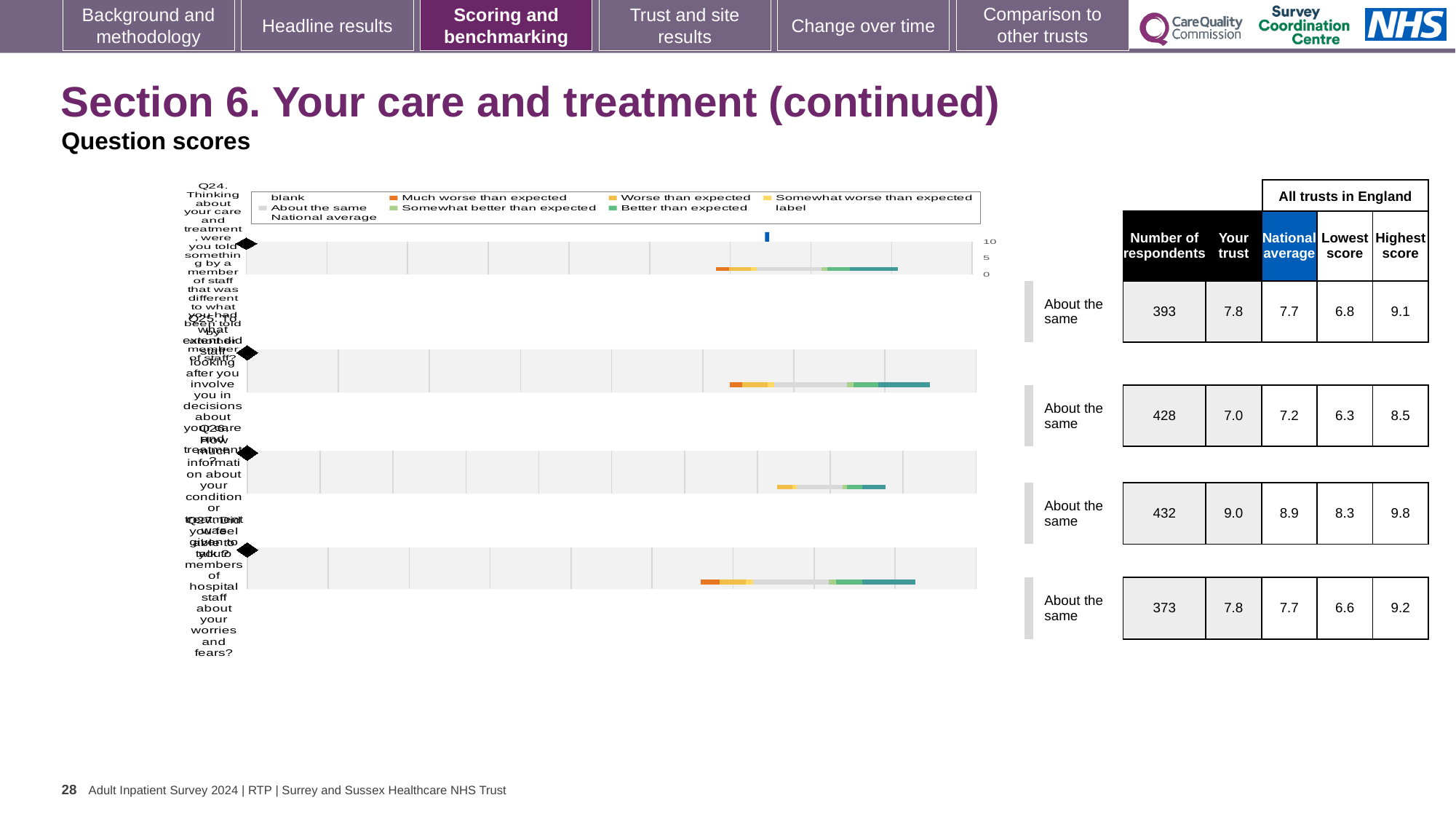
According to the table beside the chart, what is the national average for Q25? 7.2 Which question has the lowest 'Your trust' score in the table beside the chart? Q25 What is the highest tick value shown on the chart's axis? 10 Which question has the highest 'Your trust' score in the table beside the chart? Q26 What is the difference between the highest score and the lowest score for Q26 in the table beside the chart? 1.5 Which legend entry in the chart is shown in orange-red? Much worse than expected How many question rows (categories) does the chart show? 4 According to the table beside the chart, what is the 'Your trust' score for Q24? 7.8 What kind of chart is shown on the slide? bar chart According to the table beside the chart, how many respondents answered Q26? 432 For Q27, which is larger in the table beside the chart: the 'Your trust' score or the national average? Your trust